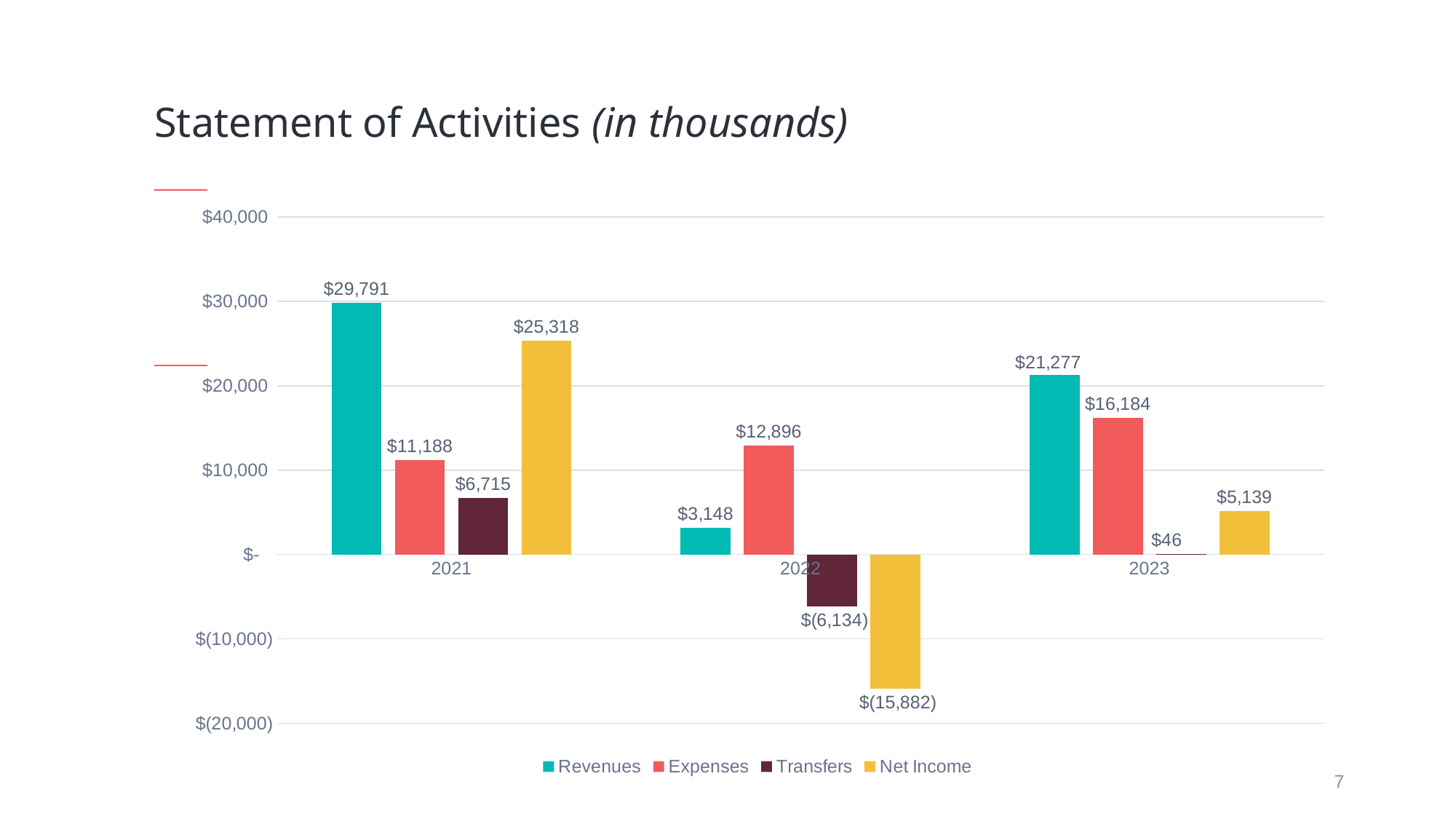
What is the value of Transfers for 2023? $46 What is the value of Expenses for 2023? $16,184 Which is larger in 2022, Revenues or Expenses? Expenses What is the difference between Revenues and Expenses in 2021? $18,603 How many series does the legend list? 4 What kind of chart is shown on the slide? Bar chart Which year has the highest Revenues? 2021 Which series is shown in yellow? Net Income What is the value of Revenues for 2021? $29,791 How many years are shown on the x axis? 3 Which year has the lowest Net Income? 2022 What is the value of Net Income for 2022? $(15,882)